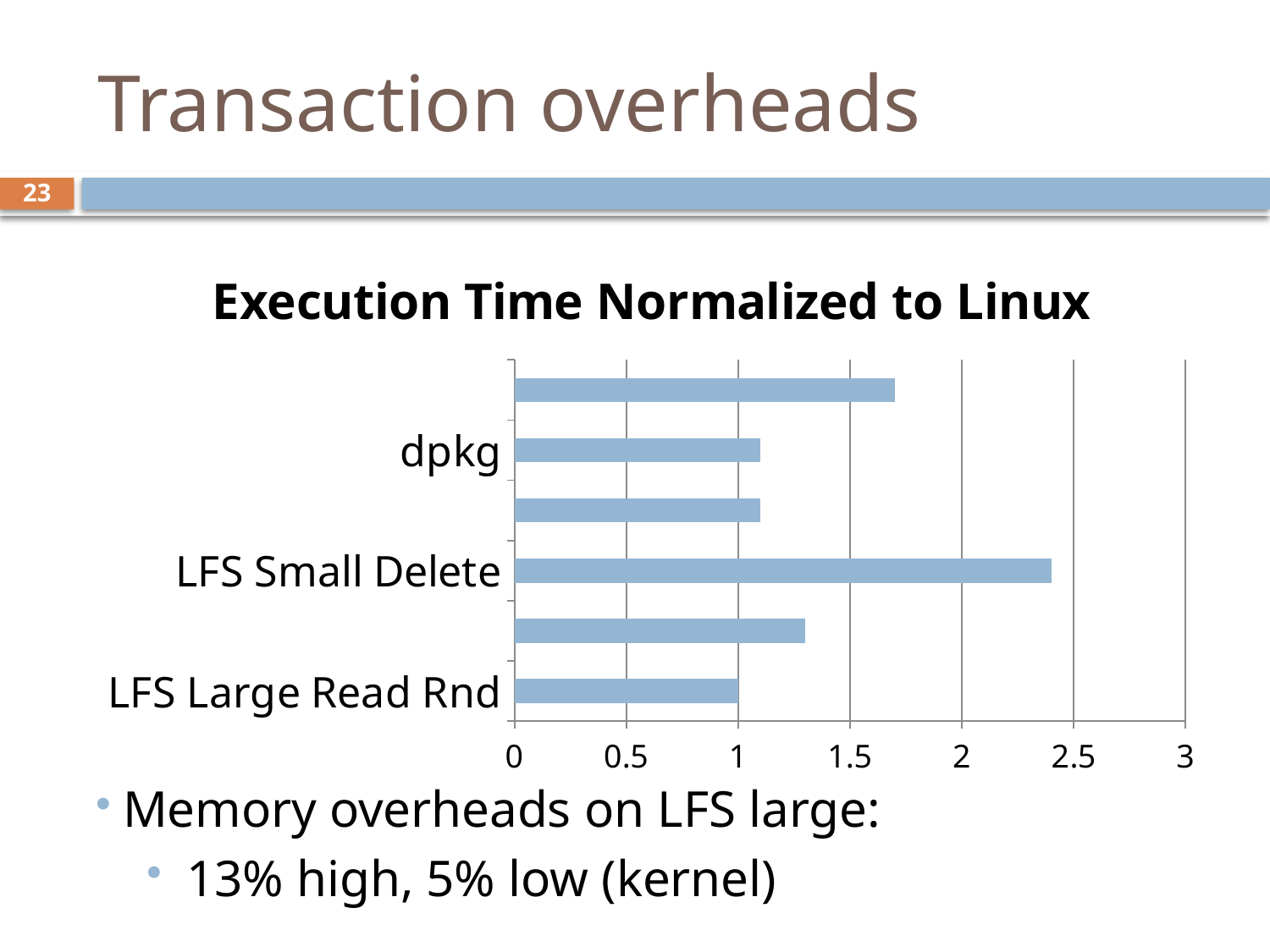
Is the value for dpkg greater or less than 1.5? less Is the value for LFS Small Delete greater or less than 2? greater Is the value for dpkg greater or less than 1? greater What is the title of the chart? Execution Time Normalized to Linux Which labeled category has the highest normalized execution time? LFS Small Delete How many bars are plotted in the chart? 6 Which has the larger normalized execution time, LFS Small Delete or LFS Large Read Rnd? LFS Small Delete What kind of chart is shown on the slide? bar chart What is the maximum value shown on the horizontal axis? 3 Which has the larger normalized execution time, LFS Small Delete or dpkg? LFS Small Delete